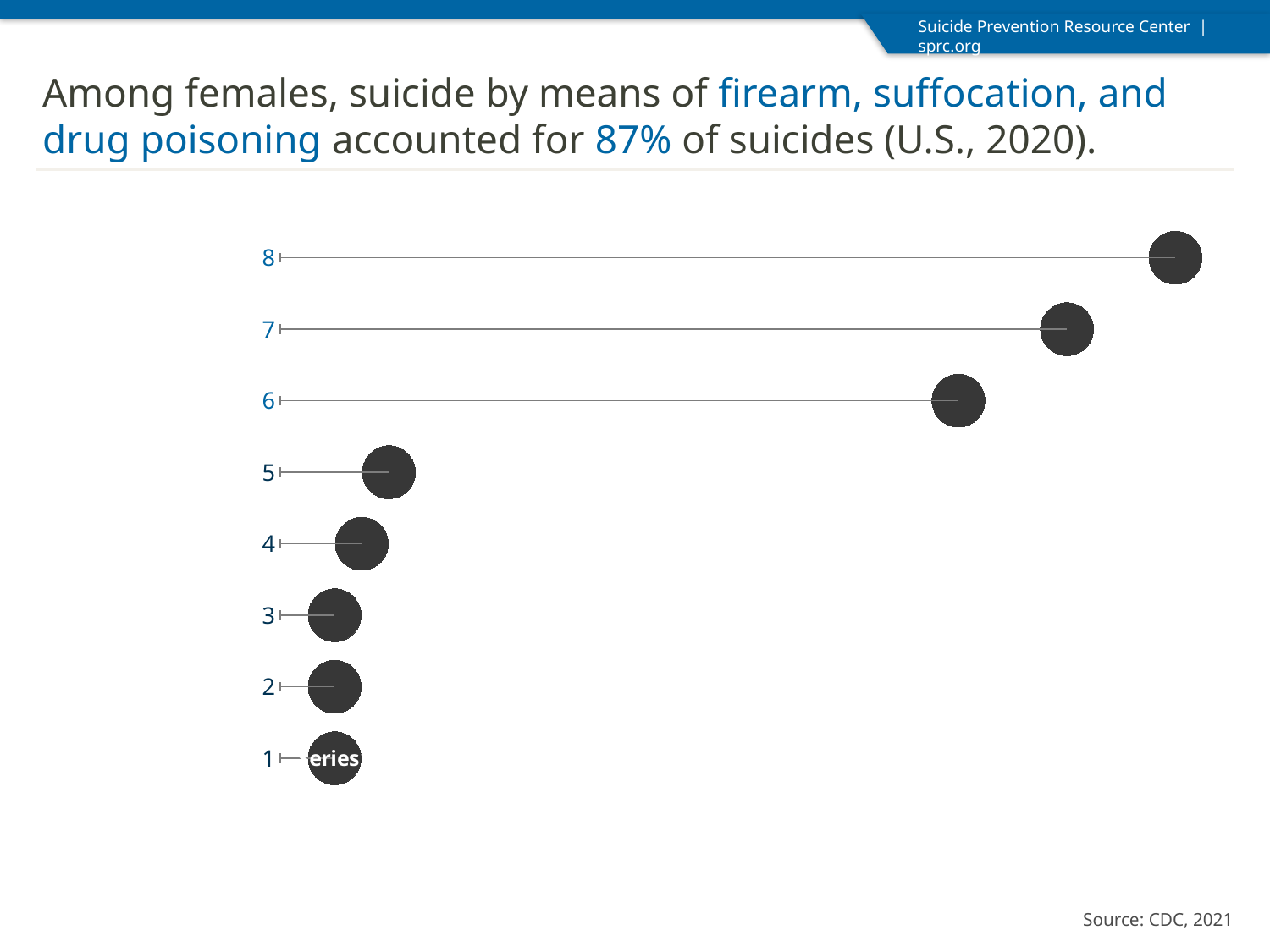
Which has the larger value on the chart, category 8 or category 7? 8 Do the bar lengths generally increase or decrease going from category 1 up to category 8? increase What source is cited at the bottom of the slide? CDC, 2021 How many categories are plotted on the chart? 8 Which has the larger value on the chart, category 1 or category 6? 6 Which has the larger value on the chart, category 6 or category 5? 6 Are the bars on the chart drawn horizontally or vertically? horizontally Which category has the longest bar on the chart? 8